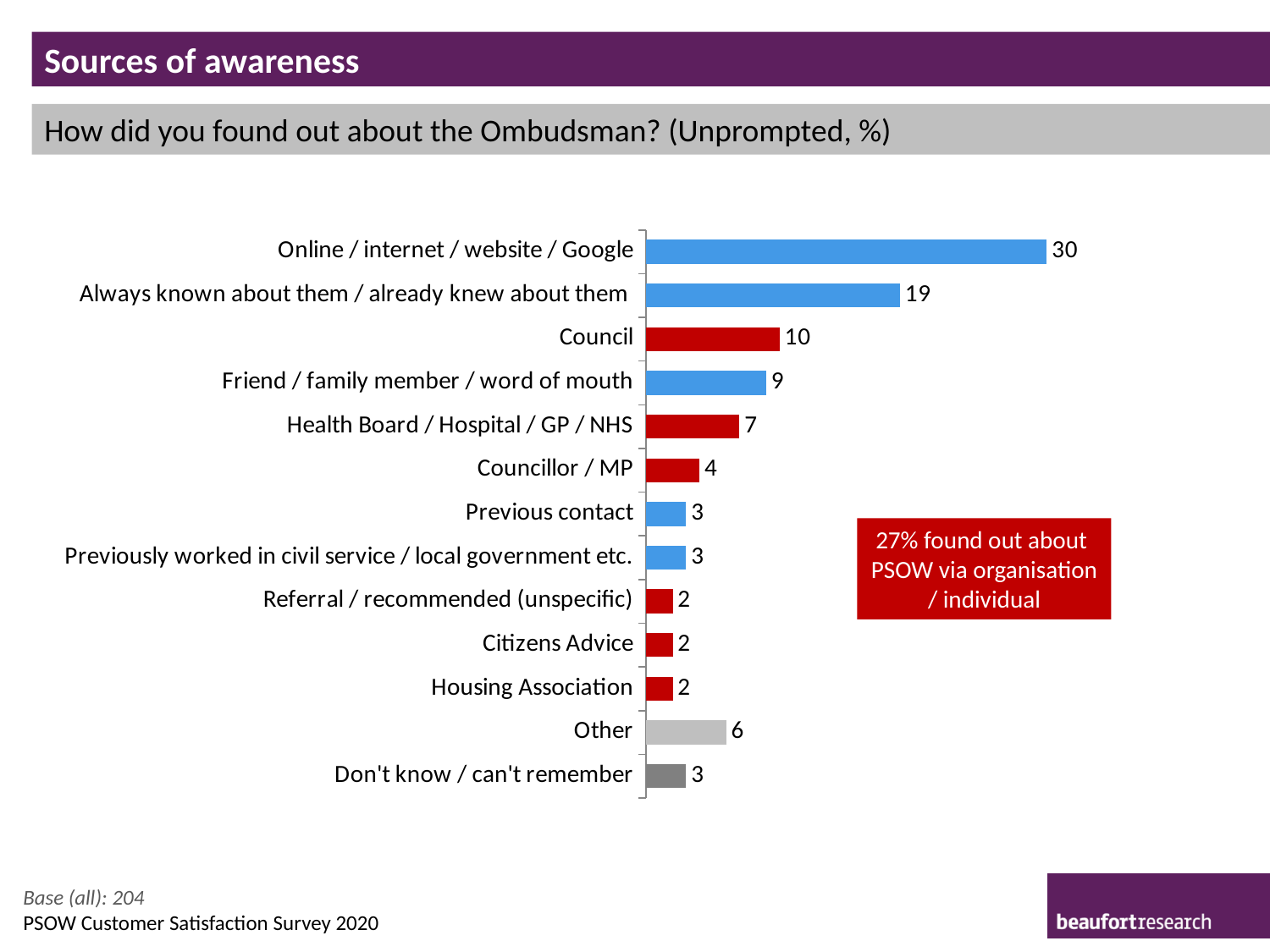
What is the difference between the values for Online / internet / website / Google and Always known about them / already knew about them? 11 According to the text box on the chart, what percentage found out about PSOW via organisation / individual? 27% Which category has the highest value? Online / internet / website / Google What value is shown for Health Board / Hospital / GP / NHS? 7 What kind of chart is shown on the slide? Bar chart What value is shown for Online / internet / website / Google? 30 What is the base (all) stated on the slide? 204 What is the difference between the values for Council and Councillor / MP? 6 How many categories are shown in the chart? 13 What value is shown for Council? 10 Which is larger, the value for Friend / family member / word of mouth or the value for Other? Friend / family member / word of mouth What value is shown for Don't know / can't remember? 3